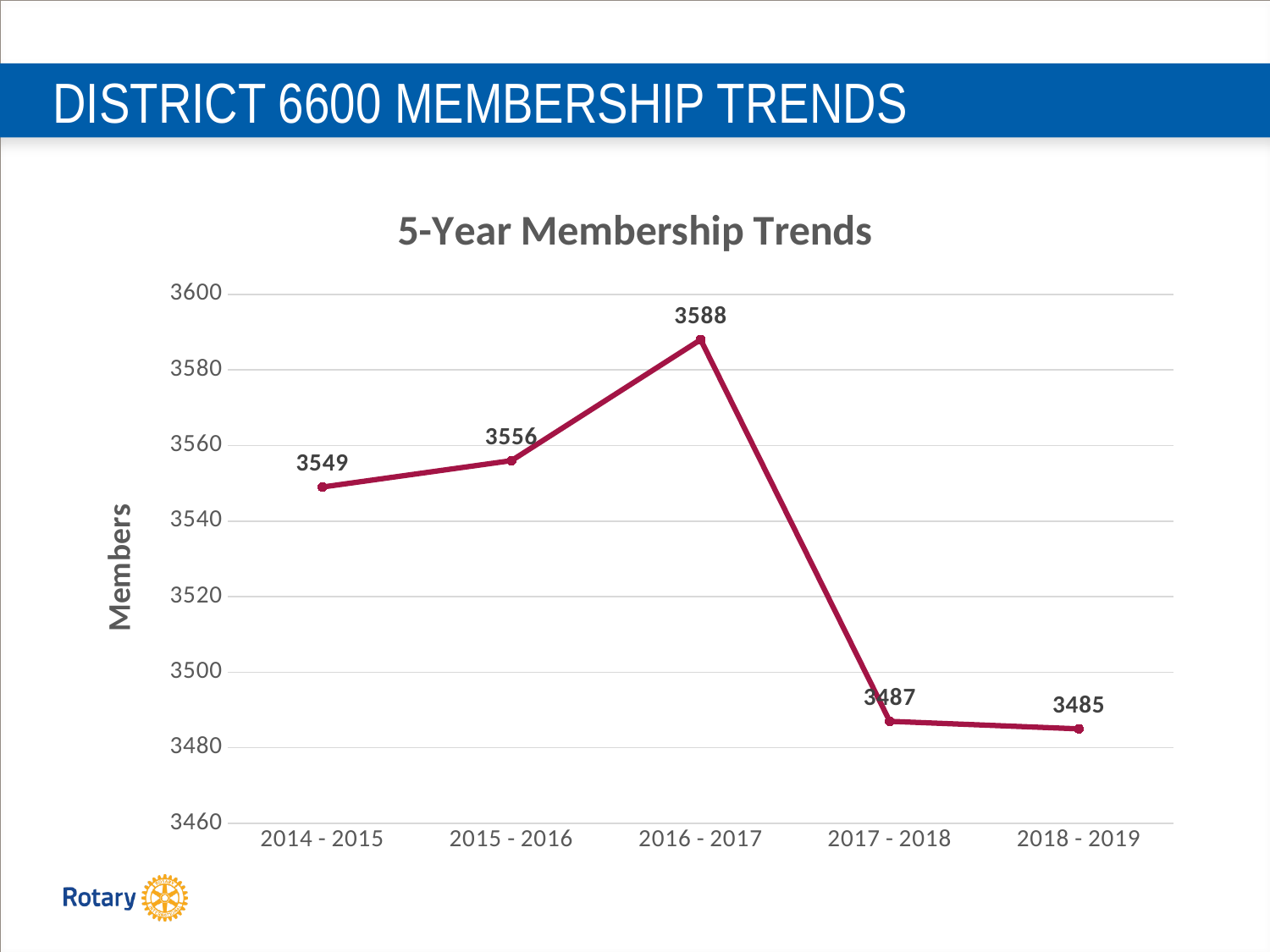
Which is larger, the membership for 2015 - 2016 or for 2017 - 2018? 2015 - 2016 What is the membership value for 2018 - 2019? 3485 Is the membership value for 2017 - 2018 greater or less than 3500? less What kind of chart is shown on the slide? line chart Which year has the highest membership? 2016 - 2017 What is the difference in membership between 2015 - 2016 and 2014 - 2015? 7 Which year has the lowest membership? 2018 - 2019 What is the membership value for 2016 - 2017? 3588 What is the membership value for 2014 - 2015? 3549 What is the difference in membership between 2016 - 2017 and 2017 - 2018? 101 What is the title of the chart? 5-Year Membership Trends How many years are plotted on the chart? 5